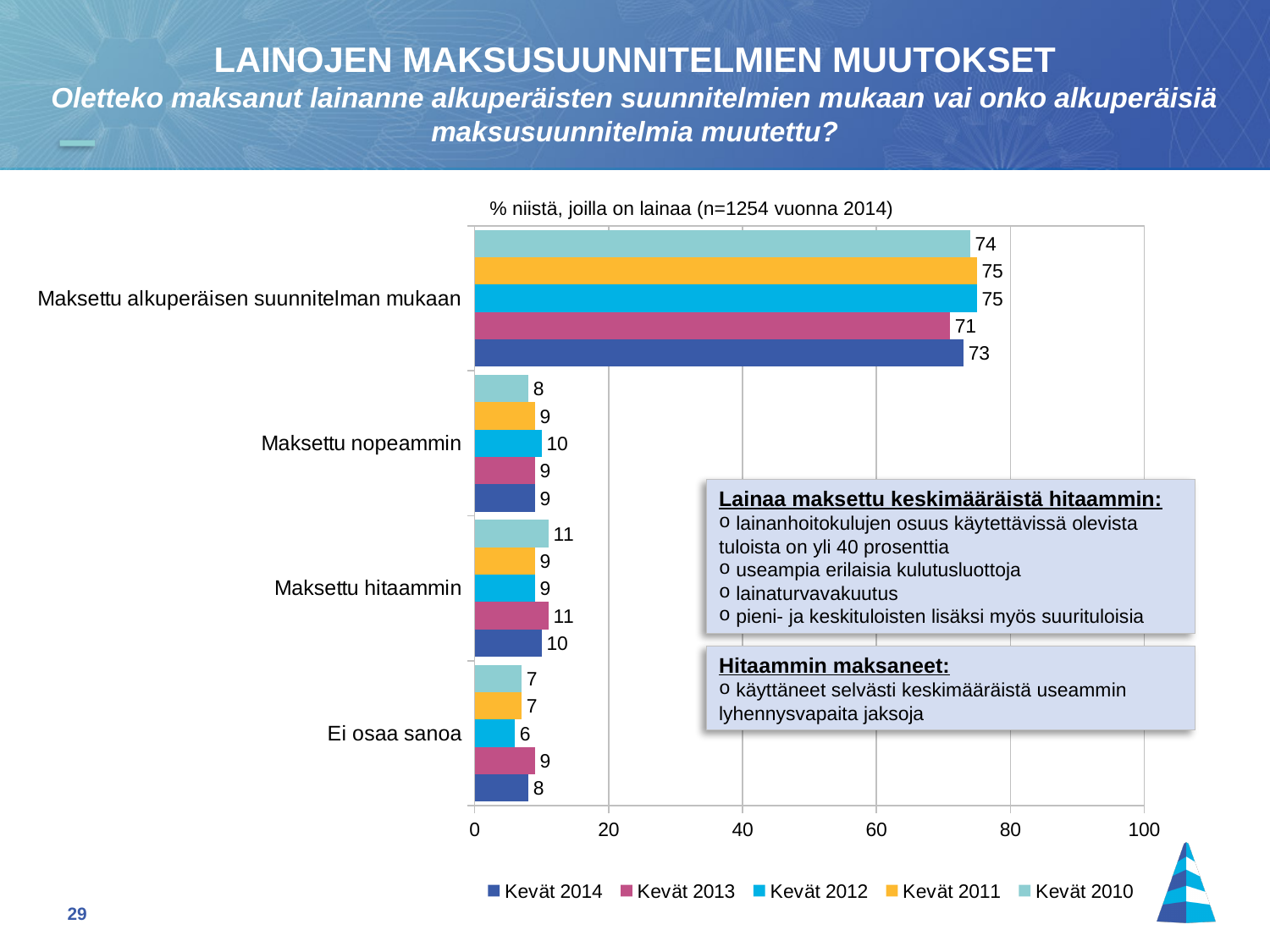
Which category has the lowest value in the Kevät 2012 series? Ei osaa sanoa What is the value for "Ei osaa sanoa" in the Kevät 2012 series? 6 What is the difference between the Kevät 2012 and Kevät 2013 values for "Maksettu alkuperäisen suunnitelman mukaan"? 4 How many categories are shown on the chart? 4 Which category has the highest value in the Kevät 2014 series? Maksettu alkuperäisen suunnitelman mukaan For "Ei osaa sanoa", which is larger: the Kevät 2013 value or the Kevät 2014 value? Kevät 2013 What is the value for "Maksettu nopeammin" in the Kevät 2012 series? 10 What is the value for "Maksettu hitaammin" in the Kevät 2010 series? 11 What is the value for "Maksettu alkuperäisen suunnitelman mukaan" in the Kevät 2013 series? 71 What is the value for "Maksettu alkuperäisen suunnitelman mukaan" in the Kevät 2014 series? 73 What kind of chart is shown on the slide? Bar chart How many series does the legend list? 5